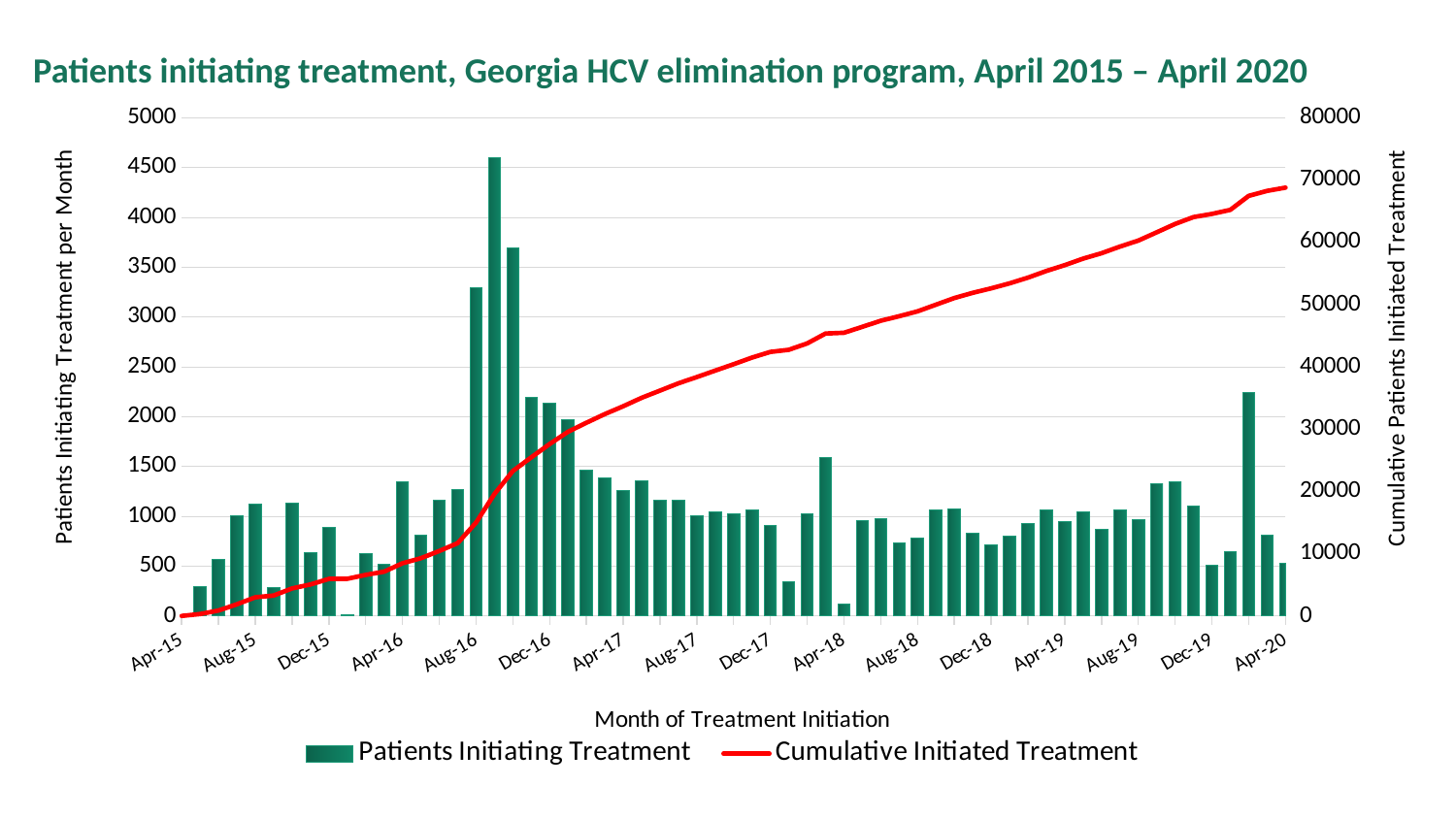
Is the number of Patients Initiating Treatment in Apr-18 greater or less than 500? less Which is larger, the number of Patients Initiating Treatment in Aug-16 or in Apr-18? Aug-16 Is the number of Patients Initiating Treatment in Aug-16 greater or less than 3000? greater Is the Cumulative Initiated Treatment value at Apr-20 greater or less than 60000? greater Does the Cumulative Initiated Treatment line rise or fall from Apr-15 to Apr-20? Rises What is the label of the right-hand vertical axis? Cumulative Patients Initiated Treatment What is the title of the chart? Patients initiating treatment, Georgia HCV elimination program, April 2015 – April 2020 How many series does the legend list? 2 What kind of chart is shown on the slide? A combined bar and line chart